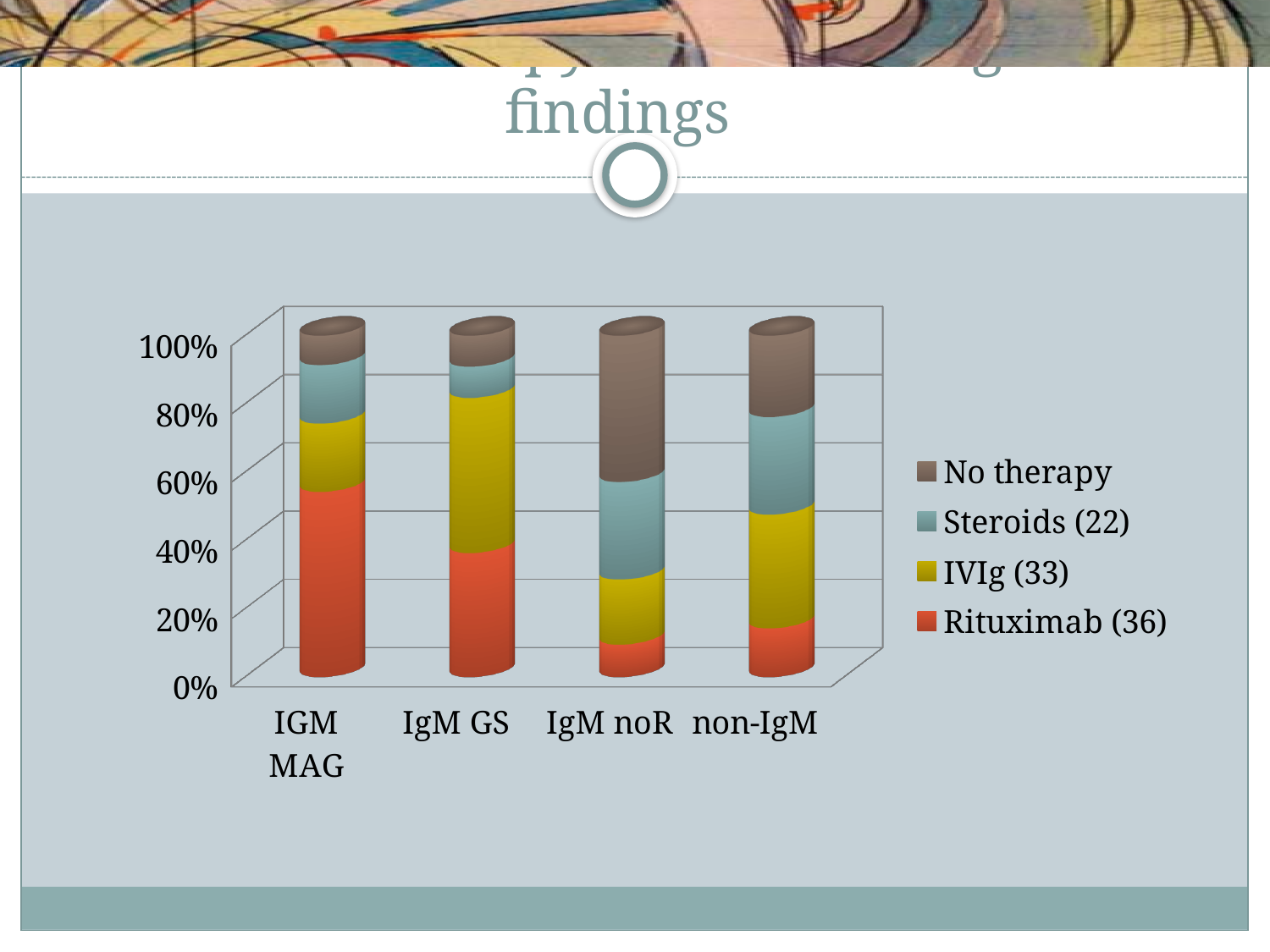
What kind of chart is shown on the slide? Stacked bar chart Which category has the largest Rituximab share? IGM MAG Is the Rituximab share for IGM MAG greater or less than 40%? greater Which category has the largest No therapy share? IgM noR How many series does the chart's legend list? 4 Is the Rituximab share for IgM noR greater or less than 20%? less Which category has the largest IVIg share? IgM GS Which legend entry is shown with the number 36 in parentheses? Rituximab (36) Which has the larger No therapy share, IgM noR or IGM MAG? IgM noR How many categories are shown on the x axis of the chart? 4 Which has the larger Rituximab share, IGM MAG or IgM GS? IGM MAG Which series is shown in yellow in the chart? IVIg (33)